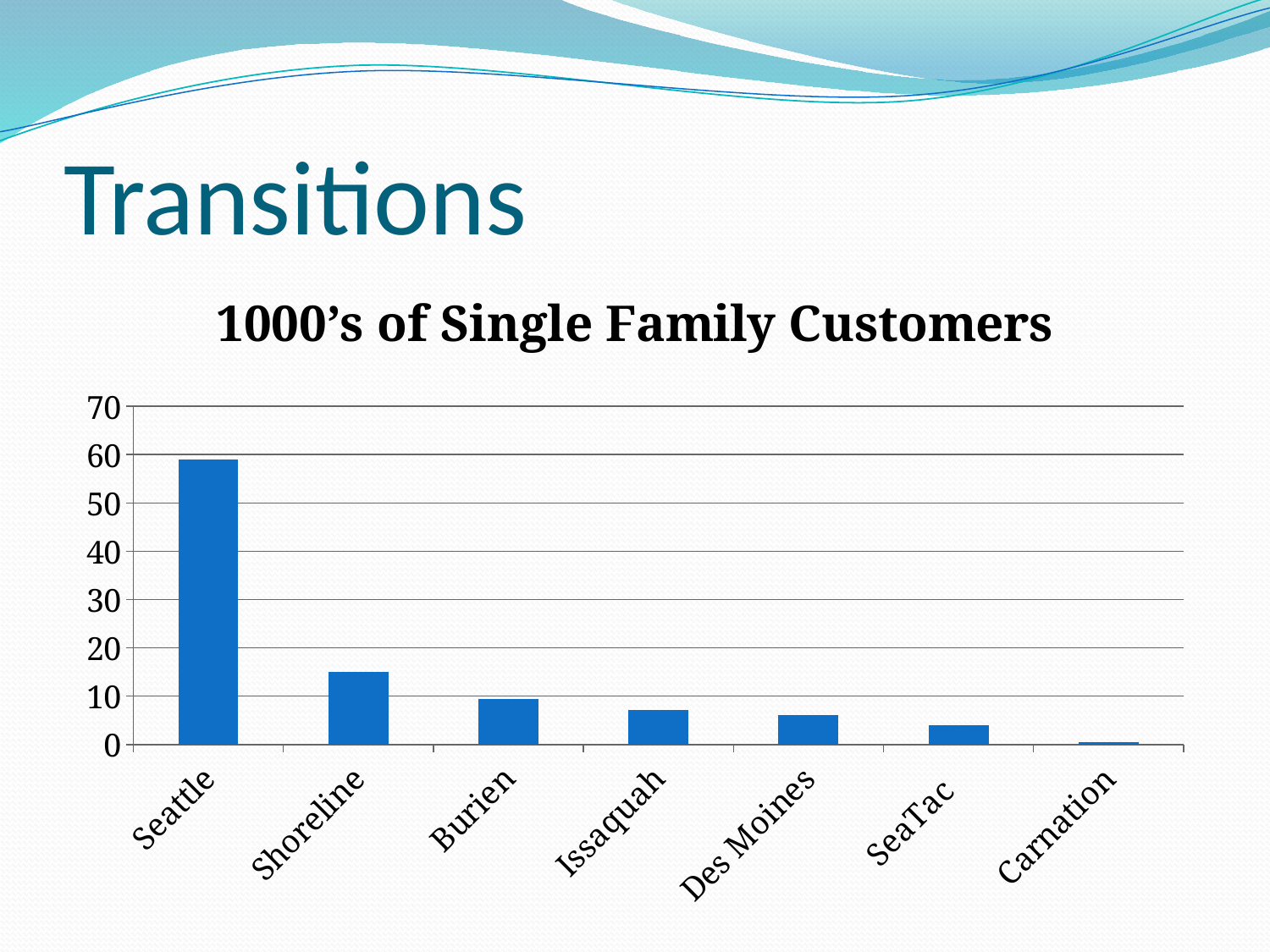
How many cities are shown on the x axis of the chart? 7 Which city has the lowest value in the chart? Carnation Is the value for Seattle greater or less than 50? greater What is the title of the chart? 1000's of Single Family Customers Is the value for Shoreline greater or less than 20? less Do the values rise or fall moving from left to right along the x axis? fall What kind of chart is shown on the slide? bar chart Which has a larger value, Shoreline or Burien? Shoreline Which city has the highest value in the chart? Seattle Which has a larger value, SeaTac or Issaquah? Issaquah What is the highest value shown on the vertical axis of the chart? 70